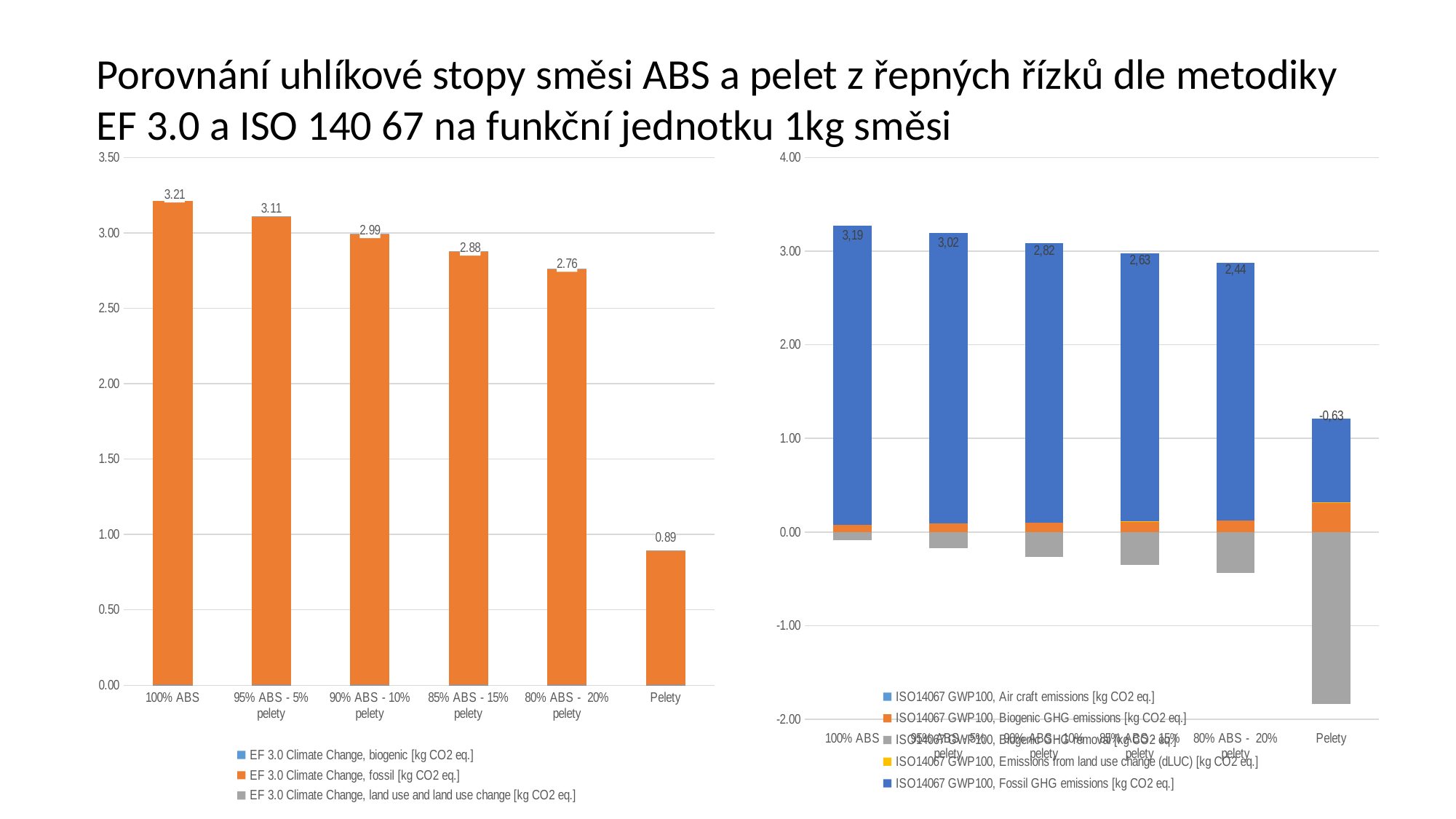
In the left chart (EF 3.0), what is the difference between the values for 100% ABS and 80% ABS - 20% pelety? 0.45 In the left chart (EF 3.0), do the values rise or fall from 100% ABS to 80% ABS - 20% pelety? fall In the right chart (ISO 14067), how many series does the legend list? 5 In the left chart (EF 3.0), which category has the highest value? 100% ABS In the left chart (EF 3.0), how many categories are shown on the x axis? 6 In the left chart (EF 3.0), what is the value for Pelety? 0.89 In the left chart (EF 3.0), which category has the lowest value? Pelety What kind of chart is the right chart (ISO 14067)? stacked bar chart In the right chart (ISO 14067), what data label is shown for 100% ABS? 3,19 In the left chart (EF 3.0), what is the value for 100% ABS? 3.21 In the right chart (ISO 14067), what data label is shown for Pelety? -0,63 In the right chart (ISO 14067), is the data label for 85% ABS - 15% pelety greater or less than 3.00? less